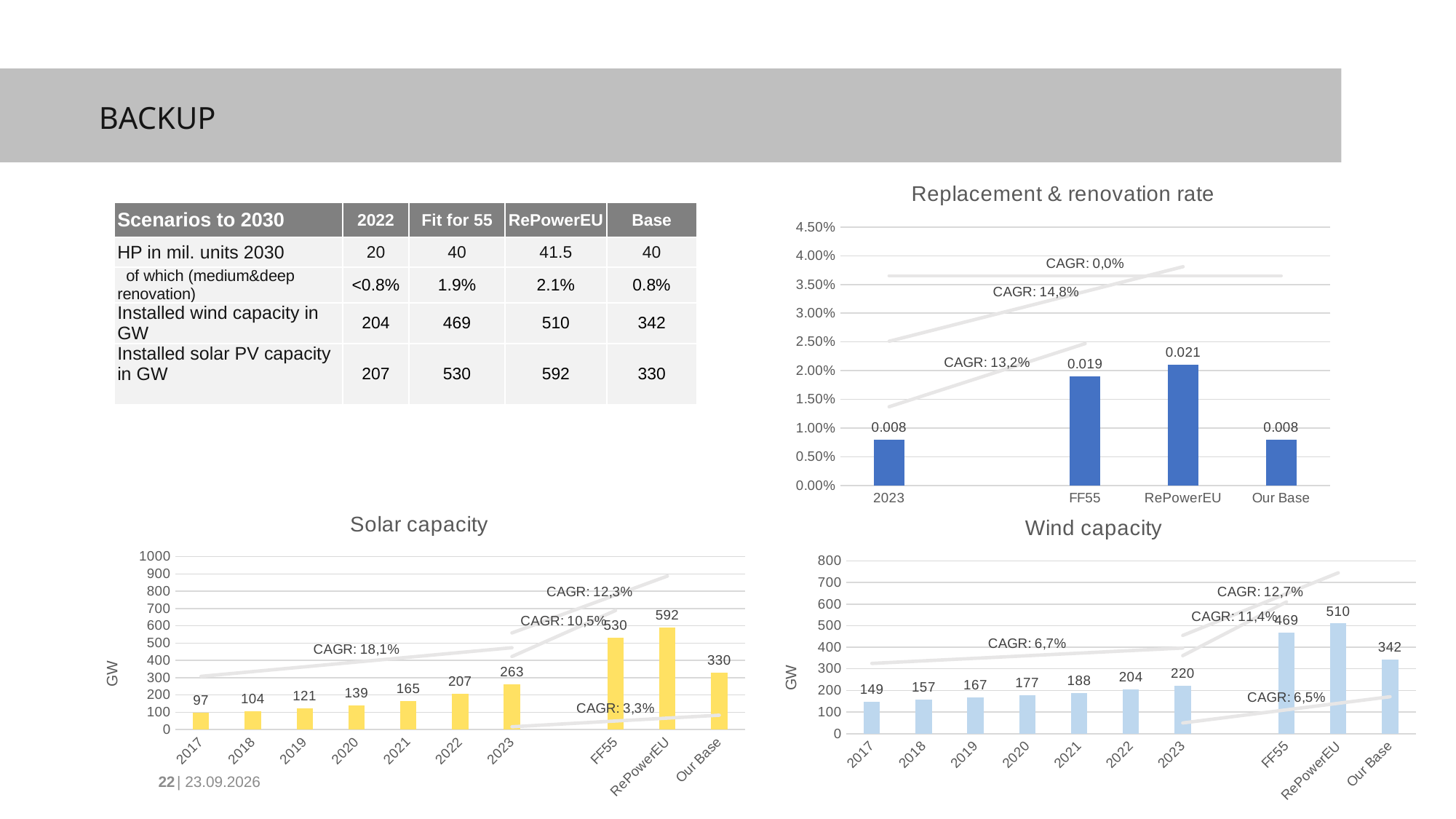
In the Replacement & renovation rate chart, which category has the highest value? RePowerEU What kind of chart is the Replacement & renovation rate chart? bar chart In the Replacement & renovation rate chart, what is the value for FF55? 0.019 In the Solar capacity chart, what is the value for RePowerEU? 592 In the Wind capacity chart, what is the value for 2023? 220 What is the y-axis label of the Wind capacity chart? GW In the Wind capacity chart, is the value for FF55 greater or less than 400? greater In the Solar capacity chart, which is larger, the value for FF55 or the value for Our Base? FF55 In the Solar capacity chart, do the values rise or fall from 2017 to 2023? rise How many categories are shown on the x axis of the Wind capacity chart? 10 In the Wind capacity chart, what is the difference between the RePowerEU value and the Our Base value? 168 In the Solar capacity chart, which category has the lowest value? 2017